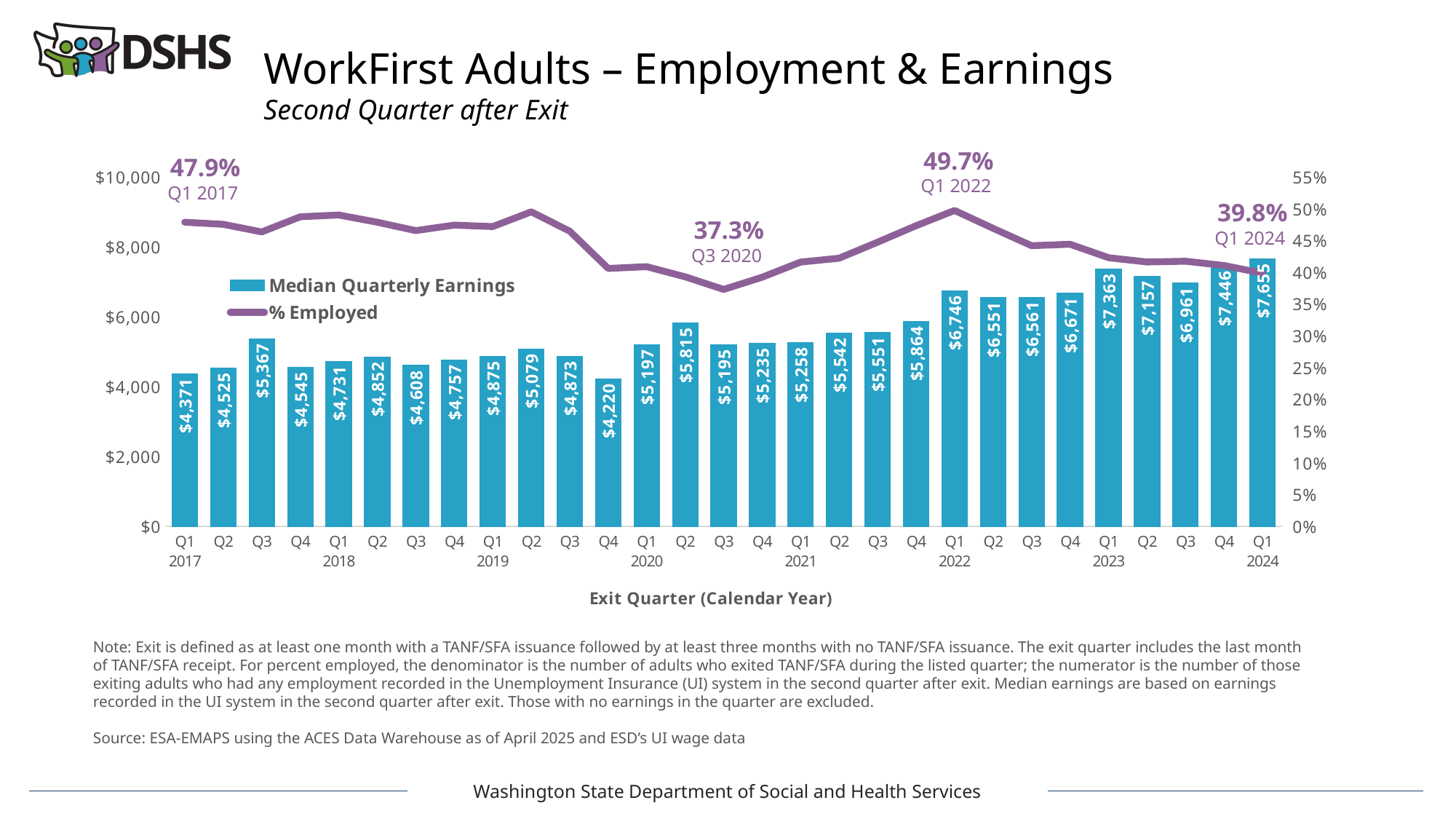
What is the difference in Median Quarterly Earnings between Q1 2024 and Q1 2017? $3,284 Which exit quarter has the lowest Median Quarterly Earnings? Q4 2019 Which has higher Median Quarterly Earnings, Q2 2020 or Q4 2021? Q4 2021 What % Employed value is labeled for Q1 2022? 49.7% What % Employed value is labeled for Q3 2020? 37.3% What kind of chart is shown on the slide? Combination bar and line chart Is the % Employed value for Q1 2018 greater or less than 45%? greater What is the Median Quarterly Earnings value for Q3 2017? $5,367 Which exit quarter has the highest Median Quarterly Earnings? Q1 2024 What is the Median Quarterly Earnings value for Q1 2024? $7,655 How many series does the legend list? 2 How many exit quarters are shown on the x axis? 29